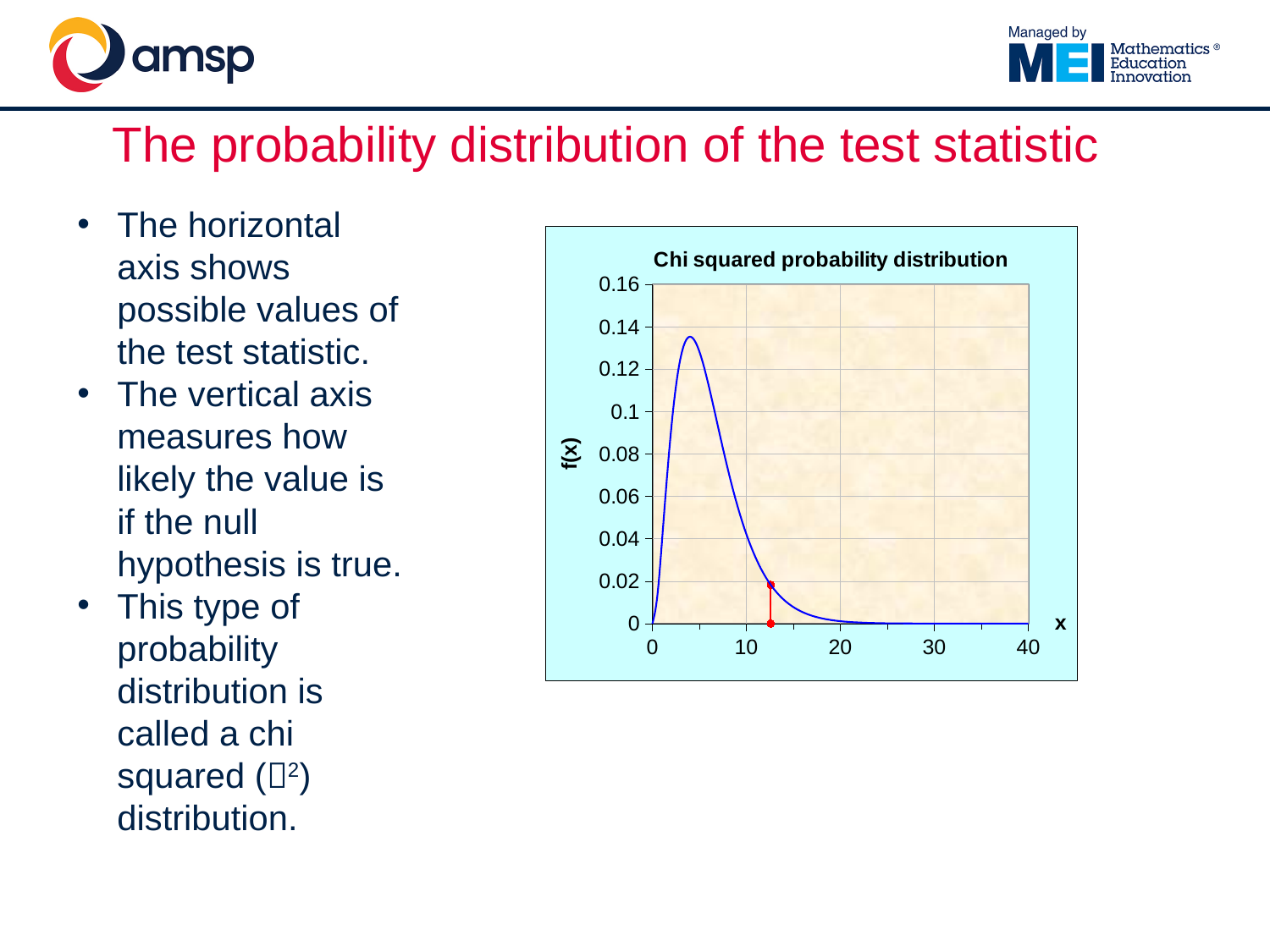
What is the title of the chart? Chi squared probability distribution Is the value of f(x) at x = 30 greater or less than 0.02? less Is the peak value of the curve greater or less than 0.12? greater What kind of chart is shown on the slide? line chart Does the curve rise or fall as x increases from 10 to 20? fall Is the value of f(x) at the peak larger than the value of f(x) at x = 20? yes What is the highest value shown on the vertical axis? 0.16 What is the highest value shown on the horizontal axis? 40 Does the curve rise or fall as x increases from 0 to 4? rise Is the peak value of the curve greater or less than 0.14? less What is the label on the vertical axis of the chart? f(x)